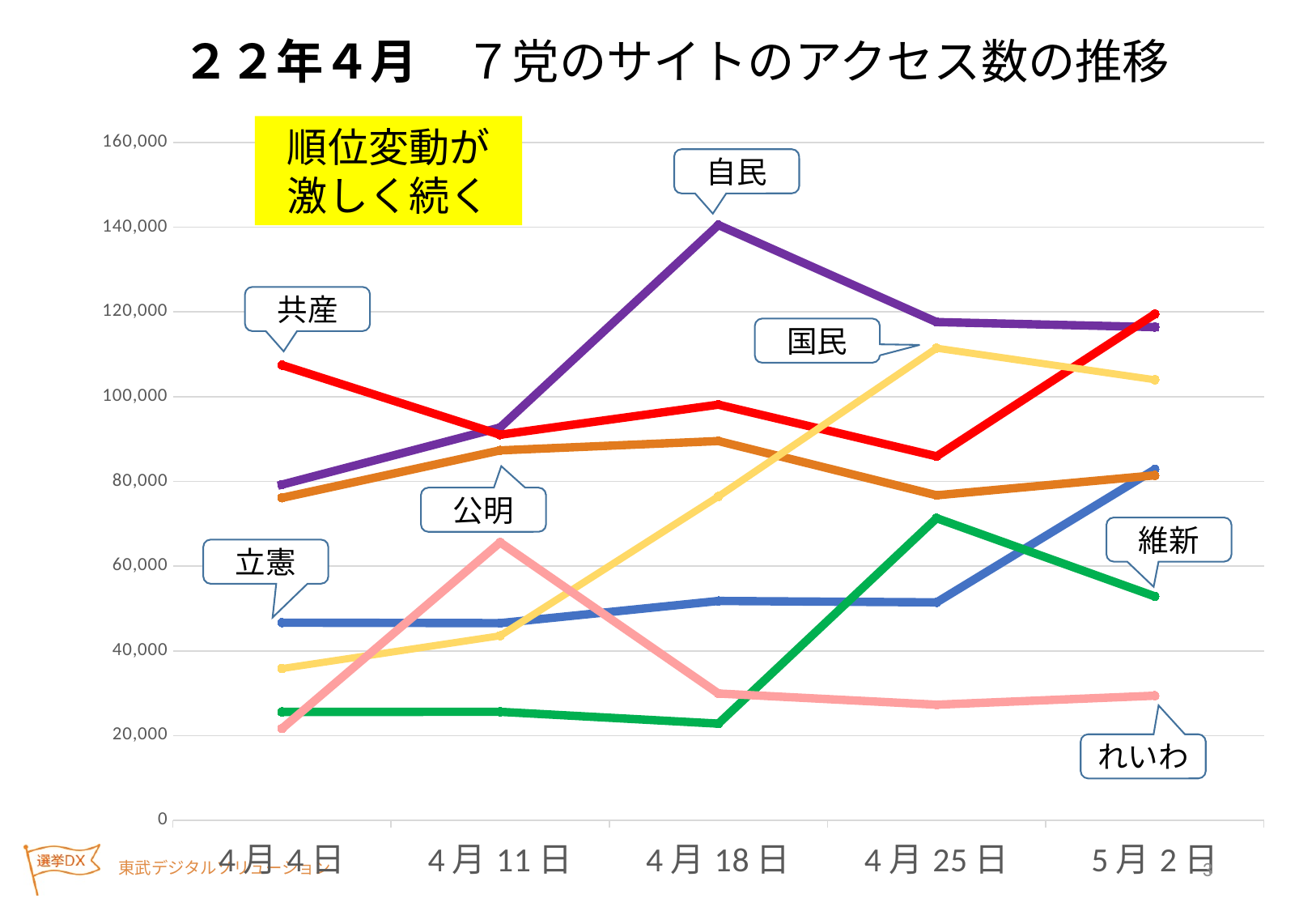
How many dates are shown along the x axis? 5 What is the title of the chart? ２２年４月 ７党のサイトのアクセス数の推移 Is the value for 国民 on 4月4日 greater or less than 40,000? less How many parties' lines are plotted on the chart? 7 Does the line for 国民 rise or fall from 4月4日 to 4月25日? rise Which party has the highest access count on 4月4日? 共産 Is the value for 立憲 on 4月4日 greater or less than 60,000? less Is the value for 共産 on 4月4日 greater or less than 100,000? greater Which party has the highest access count on 4月18日? 自民 Which is larger on 4月25日, the value for 自民 or the value for 共産? 自民 What kind of chart is shown on the slide? line chart